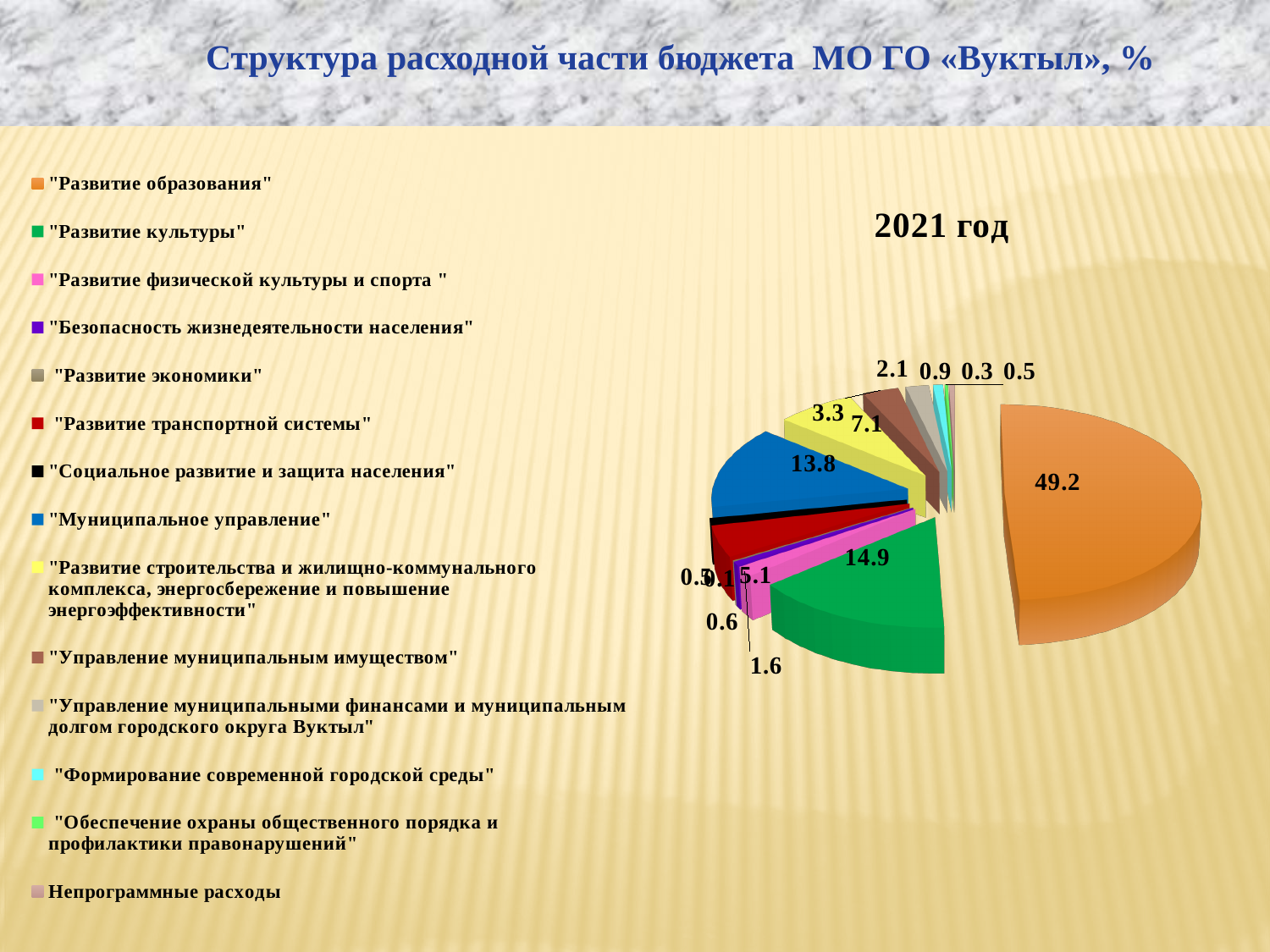
What is the value shown for "Развитие культуры"? 14.9 Which category has the largest share of the pie? "Развитие образования" What is the value shown for "Развитие строительства и жилищно-коммунального комплекса, энергосбережение и повышение энергоэффективности"? 7.1 How many categories does the legend list? 14 What title is shown above the pie chart? 2021 год What is the value shown for "Муниципальное управление"? 13.8 What is the value shown for "Безопасность жизнедеятельности населения"? 0.6 What is the value shown for "Развитие физической культуры и спорта"? 1.6 What is the value shown for "Развитие образования"? 49.2 What is the difference between the values for "Развитие образования" and "Развитие культуры"? 34.3 What kind of chart is shown on the slide? pie chart Which is larger, the value for "Развитие культуры" or for "Муниципальное управление"? "Развитие культуры"